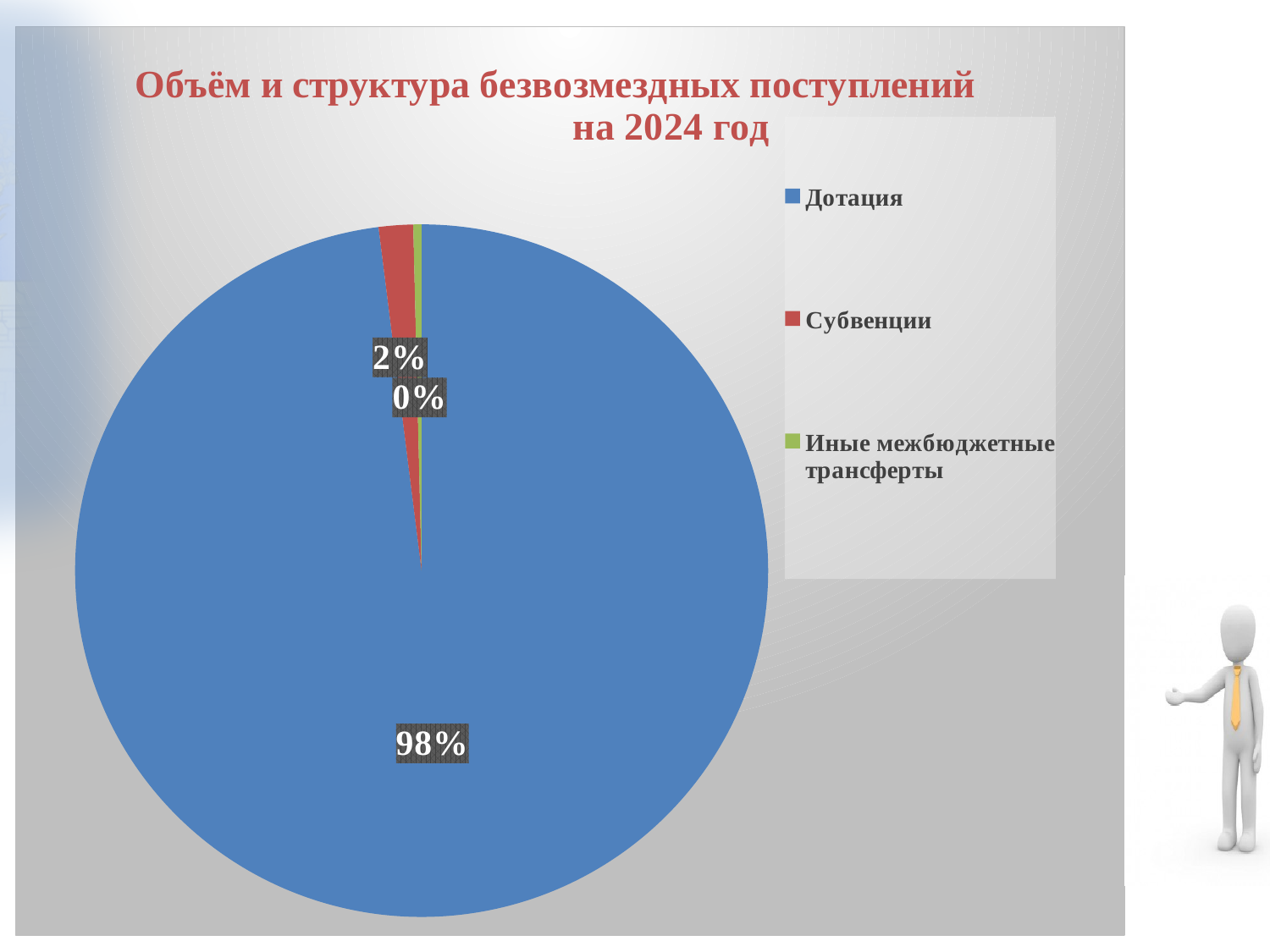
Which category has the smallest slice of the pie? Иные межбюджетные трансферты What share of the pie does Дотация account for? 98% What share of the pie does Субвенции account for? 2% What kind of chart is shown on the slide? Pie chart Is the share for Дотация greater or less than 50%? greater How many categories does the legend of the pie chart list? 3 What is the difference in percentage points between the share for Дотация and the share for Субвенции? 96% Which is larger, the share for Дотация or the share for Субвенции? Дотация Which category has the largest slice of the pie? Дотация What share of the pie does Иные межбюджетные трансферты account for? 0% What is the title of the chart? Объём и структура безвозмездных поступлений на 2024 год Which colour represents Субвенции in the pie chart? Red